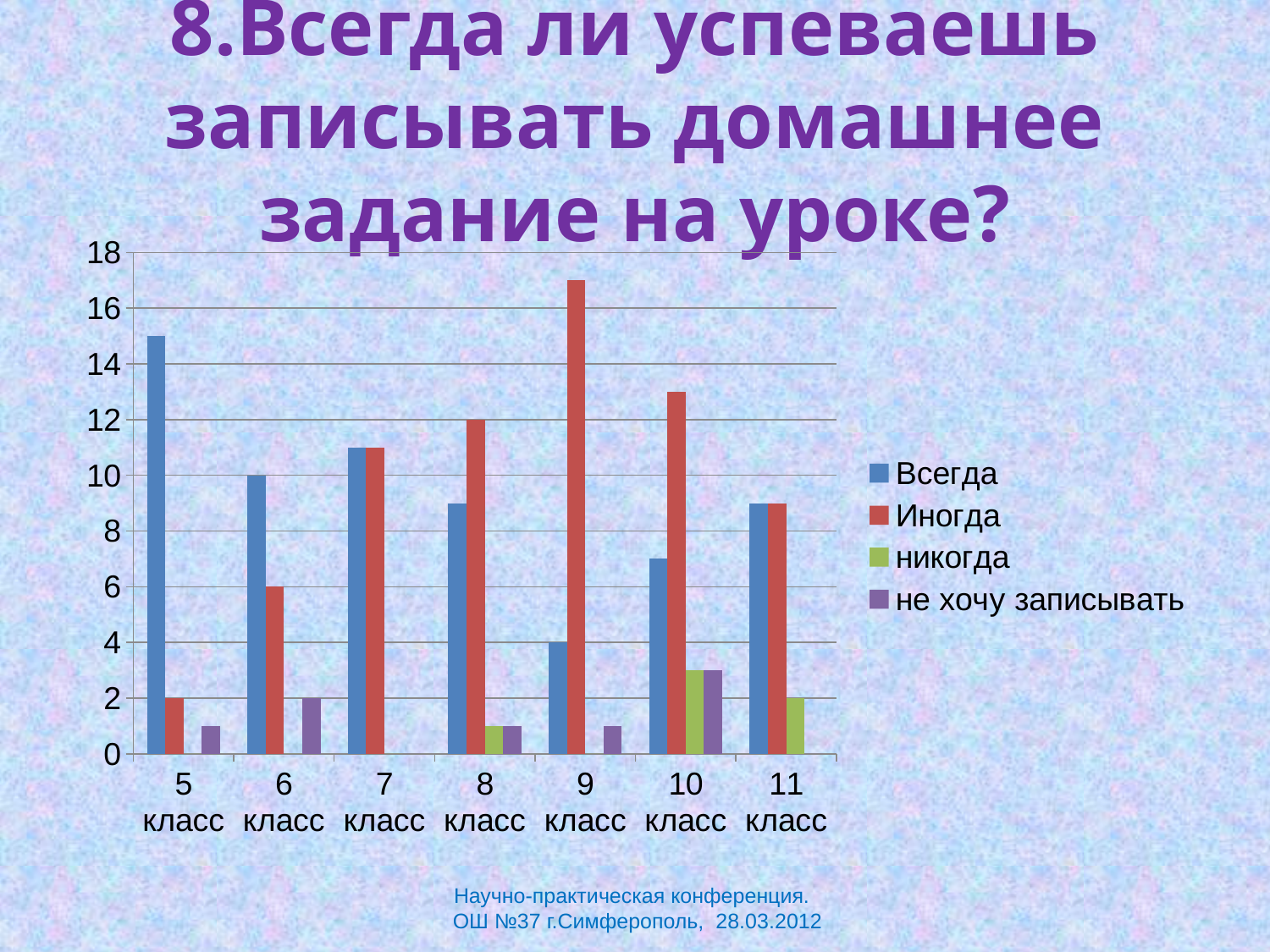
What kind of chart is shown on the slide? bar chart Which class has the highest "Иногда" value? 9 класс How many series does the legend list? 4 What is the value of "Иногда" for 8 класс? 12 Which class has the highest "Всегда" value? 5 класс For 9 класс, which is larger: "Всегда" or "Иногда"? Иногда What is the value of "Иногда" for 6 класс? 6 What is the value of "Всегда" for 6 класс? 10 What is the difference between "Всегда" and "Иногда" for 6 класс? 4 What is the value of "Всегда" for 9 класс? 4 How many classes (categories) are shown on the x axis? 7 Is the "Иногда" value for 9 класс greater or less than 16? greater